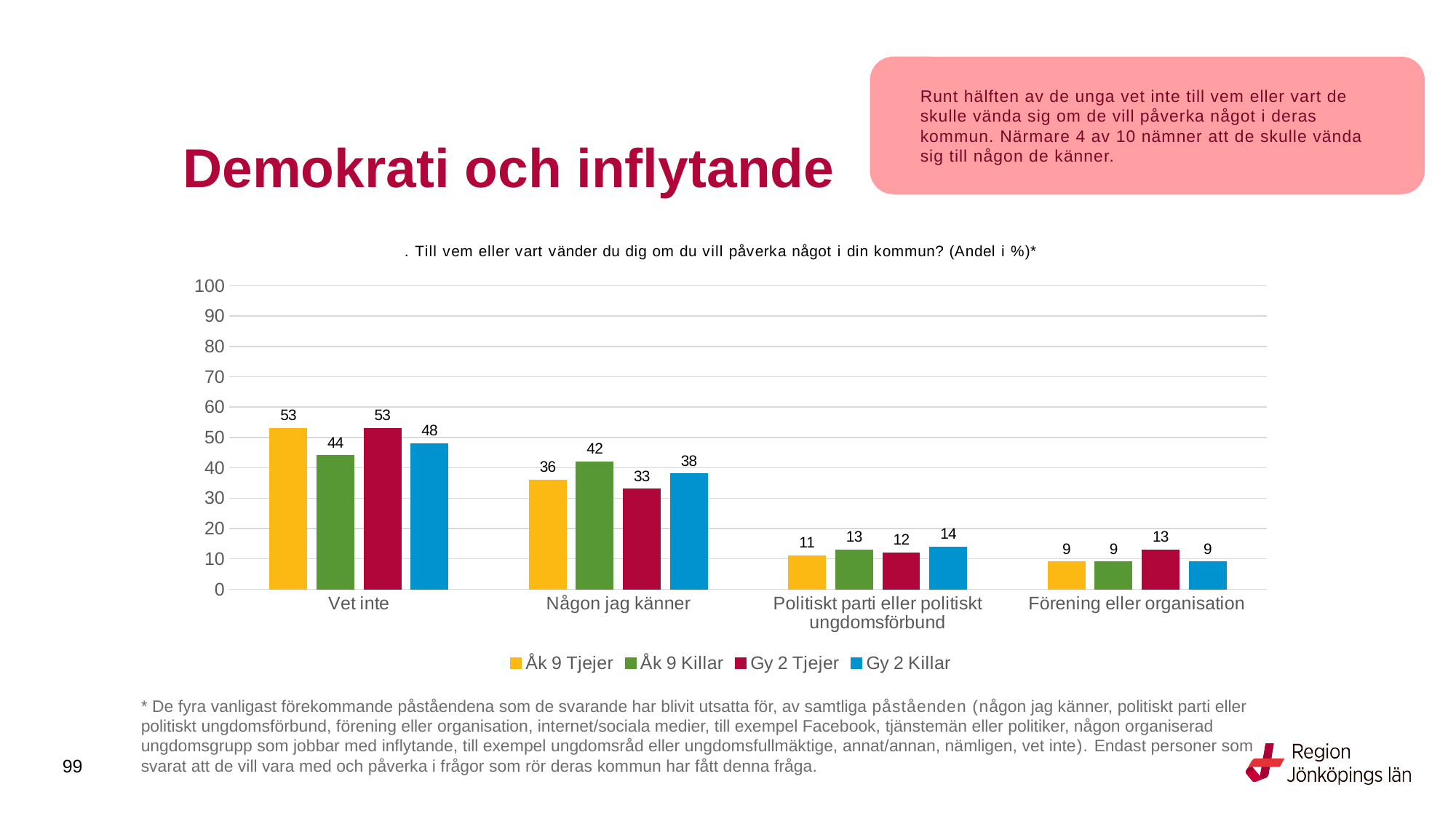
Which series has the highest value in the 'Någon jag känner' category? Åk 9 Killar Do the values for Åk 9 Tjejer rise or fall from 'Vet inte' to 'Förening eller organisation'? Fall What kind of chart is shown on the slide? Bar chart What is the value for Gy 2 Tjejer in the 'Någon jag känner' category? 33 What colour represents Gy 2 Killar in the chart? Blue How many series does the legend list? 4 What is the value for Gy 2 Killar in the 'Politiskt parti eller politiskt ungdomsförbund' category? 14 How many categories are shown on the x axis? 4 What is the value for Åk 9 Killar in the 'Vet inte' category? 44 What is the difference between Åk 9 Tjejer and Gy 2 Killar in the 'Vet inte' category? 5 Which is larger in the 'Förening eller organisation' category: Gy 2 Tjejer or Gy 2 Killar? Gy 2 Tjejer Which series has the lowest value in the 'Vet inte' category? Åk 9 Killar